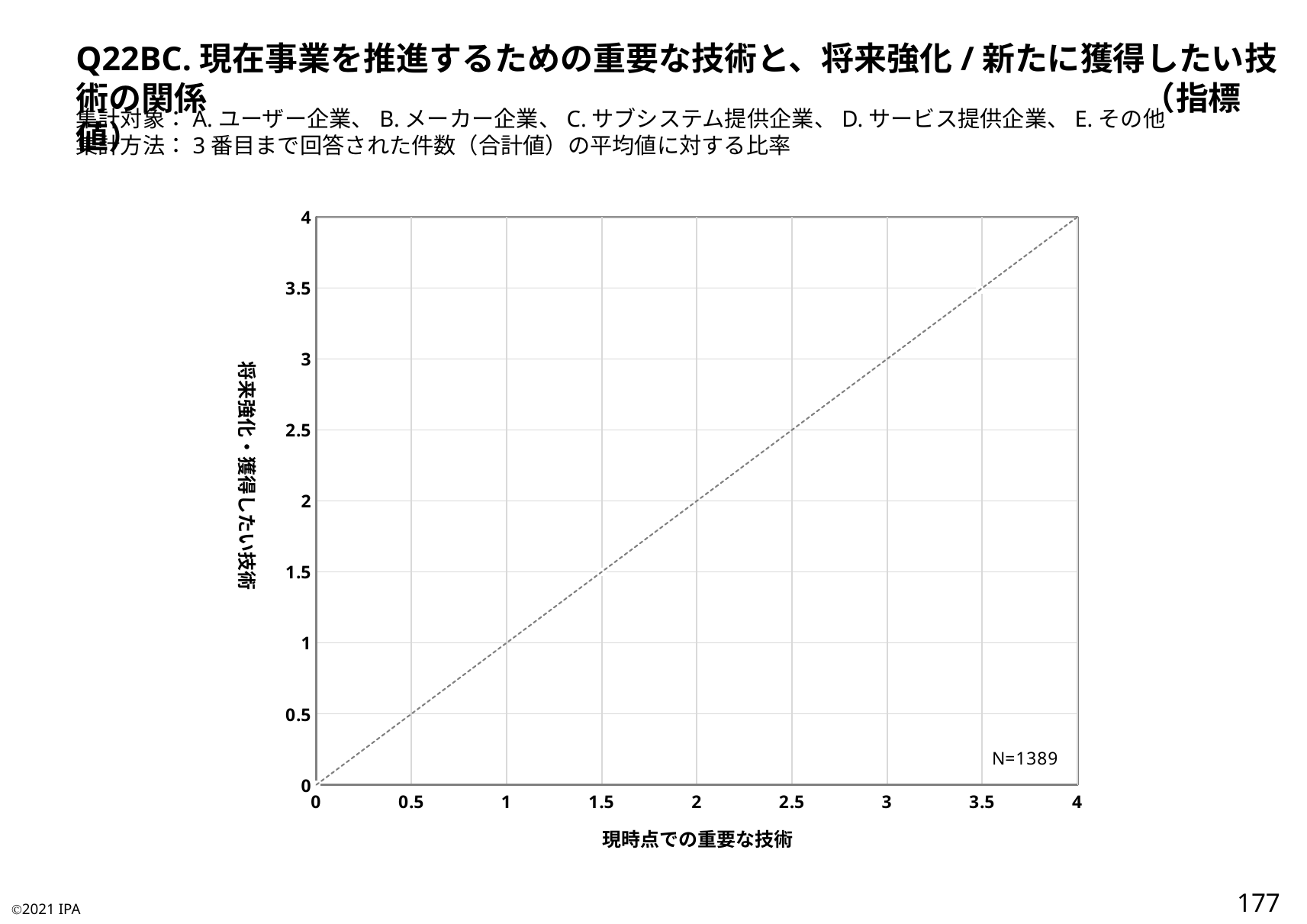
What is the label of the x axis of the chart? 現時点での重要な技術 Does the dashed reference line rise or fall as the x axis value increases? rise What is the sample size (N) shown on the chart? N=1389 What kind of chart is shown on the slide? scatter chart How many data points are plotted on the chart (excluding the dashed reference line)? 0